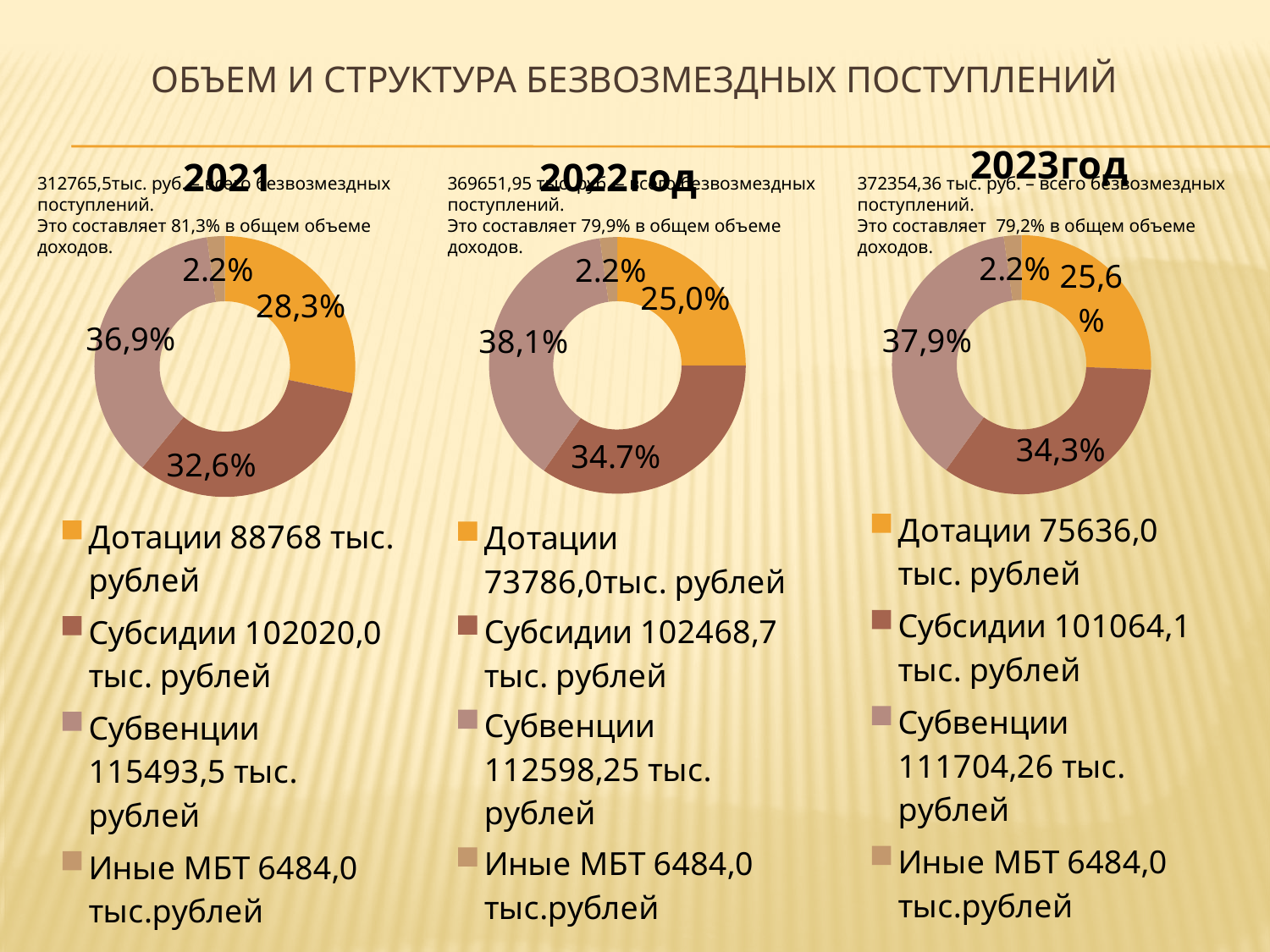
How many entries does the legend of the 2021 chart list? 4 In the 2022 chart, what amount does the legend give for Дотации? 73786,0тыс. рублей In the 2021 chart, what share of the donut is labelled for Субвенции? 36,9% In the 2023 chart, which category has the smallest share? Иные МБТ In the 2023 chart, what percentage is shown for Субсидии? 34,3% In the 2021 chart, what is the difference between the Субвенции share and the Дотации share? 8,6% How many slices does the 2022 chart have? 4 In the 2022 chart, which is larger: the share for Субсидии or the share for Дотации? Субсидии In the 2023 chart, what amount does the legend give for Субвенции? 111704,26 тыс. рублей In the 2021 chart, which category has the largest share? Субвенции What type of chart is used for the 2023 data? Donut chart In the 2022 chart, what percentage is shown for Дотации? 25,0%